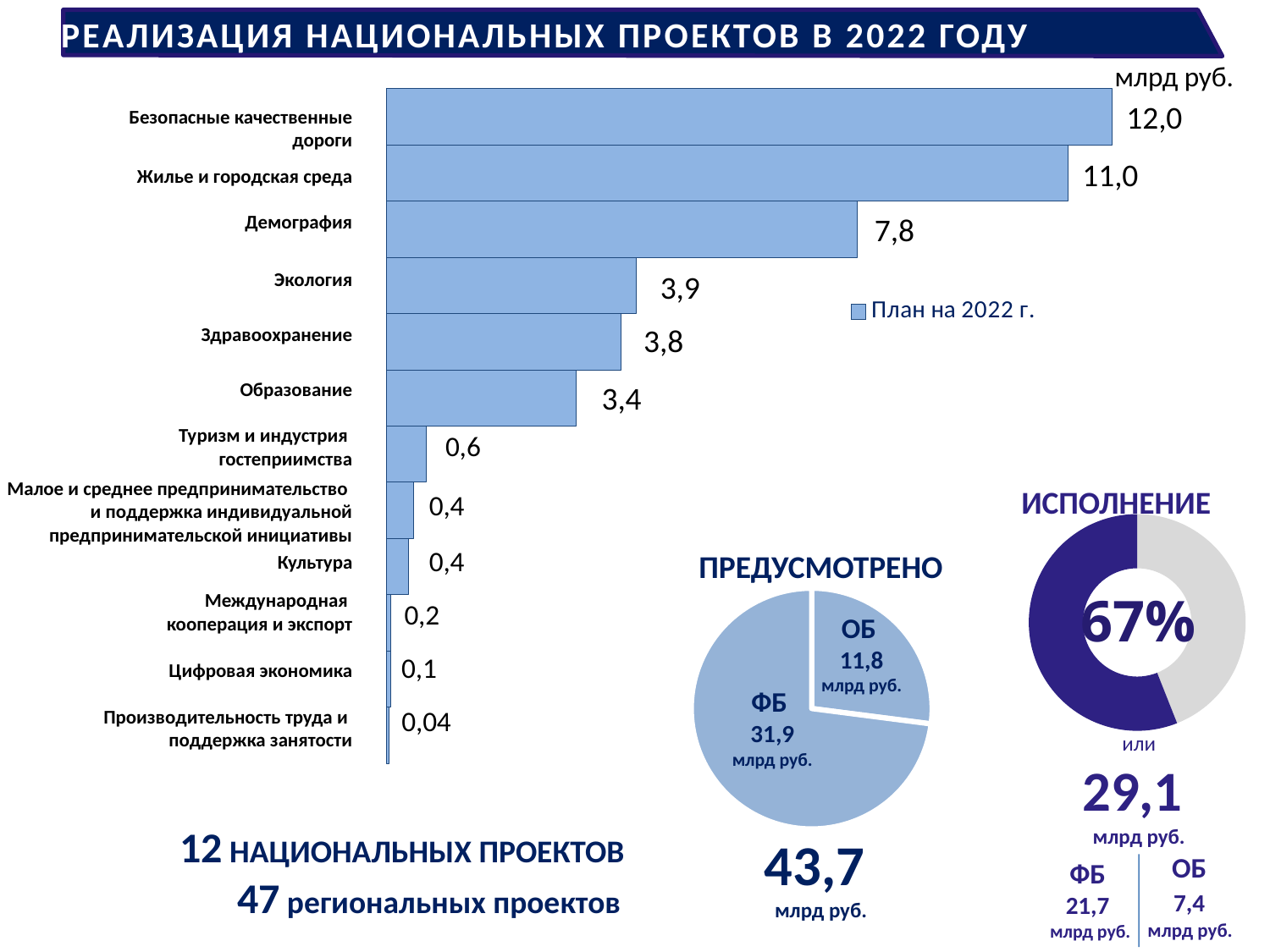
In the bar chart, what is the difference between Безопасные качественные дороги and Жилье и городская среда? 1,0 In the bar chart, what is the value for Демография? 7,8 How many series does the bar chart legend list? 1 In the ПРЕДУСМОТРЕНО pie chart, which slice is larger: ФБ or ОБ? ФБ What percentage is shown in the ИСПОЛНЕНИЕ donut chart? 67% In the bar chart, what is the value for Экология? 3,9 In the ПРЕДУСМОТРЕНО pie chart, what is the value for ФБ? 31,9 млрд руб. In the bar chart, which category has the highest value? Безопасные качественные дороги In the bar chart, which is larger: Здравоохранение or Образование? Здравоохранение In the bar chart, which category has the lowest value? Производительность труда и поддержка занятости How many categories does the bar chart show? 12 What type of chart is the chart on the left of the slide? bar chart